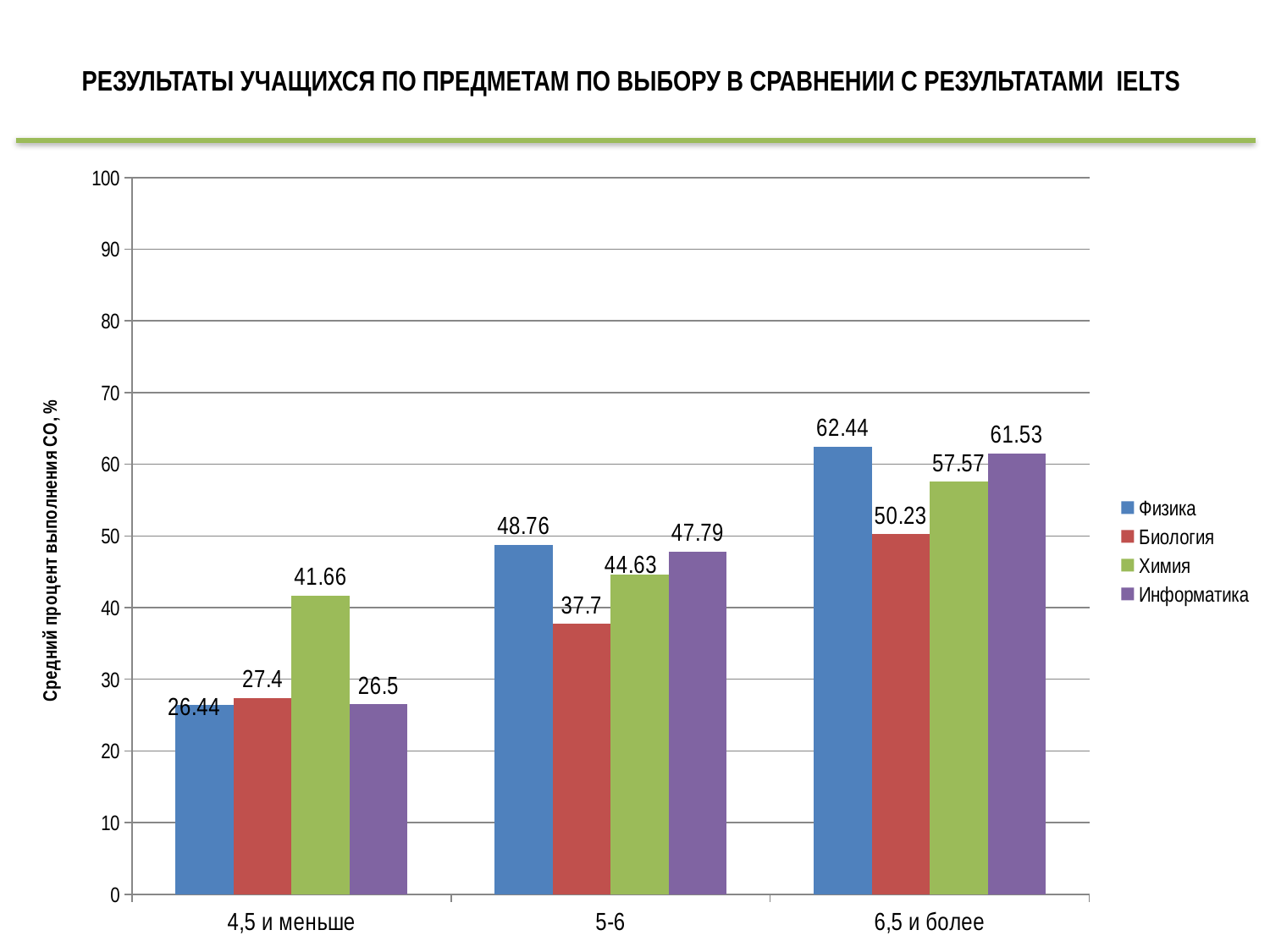
What kind of chart is shown on the slide? Bar chart What is the value for Информатика in the 6,5 и более category? 61.53 Which series has the lowest value in the 4,5 и меньше category? Физика Which is larger: Химия in the 5-6 category or Информатика in the 5-6 category? Информатика What is the value for Биология in the 5-6 category? 37.7 How many series does the legend list? 4 What is the difference between the Физика and Биология values in the 6,5 и более category? 12.21 Do the Физика values rise or fall from the 4,5 и меньше category to the 6,5 и более category? Rise What is the value for Физика in the 5-6 category? 48.76 What is the value for Химия in the 4,5 и меньше category? 41.66 Which series has the highest value in the 6,5 и более category? Физика How many categories are shown on the x axis? 3